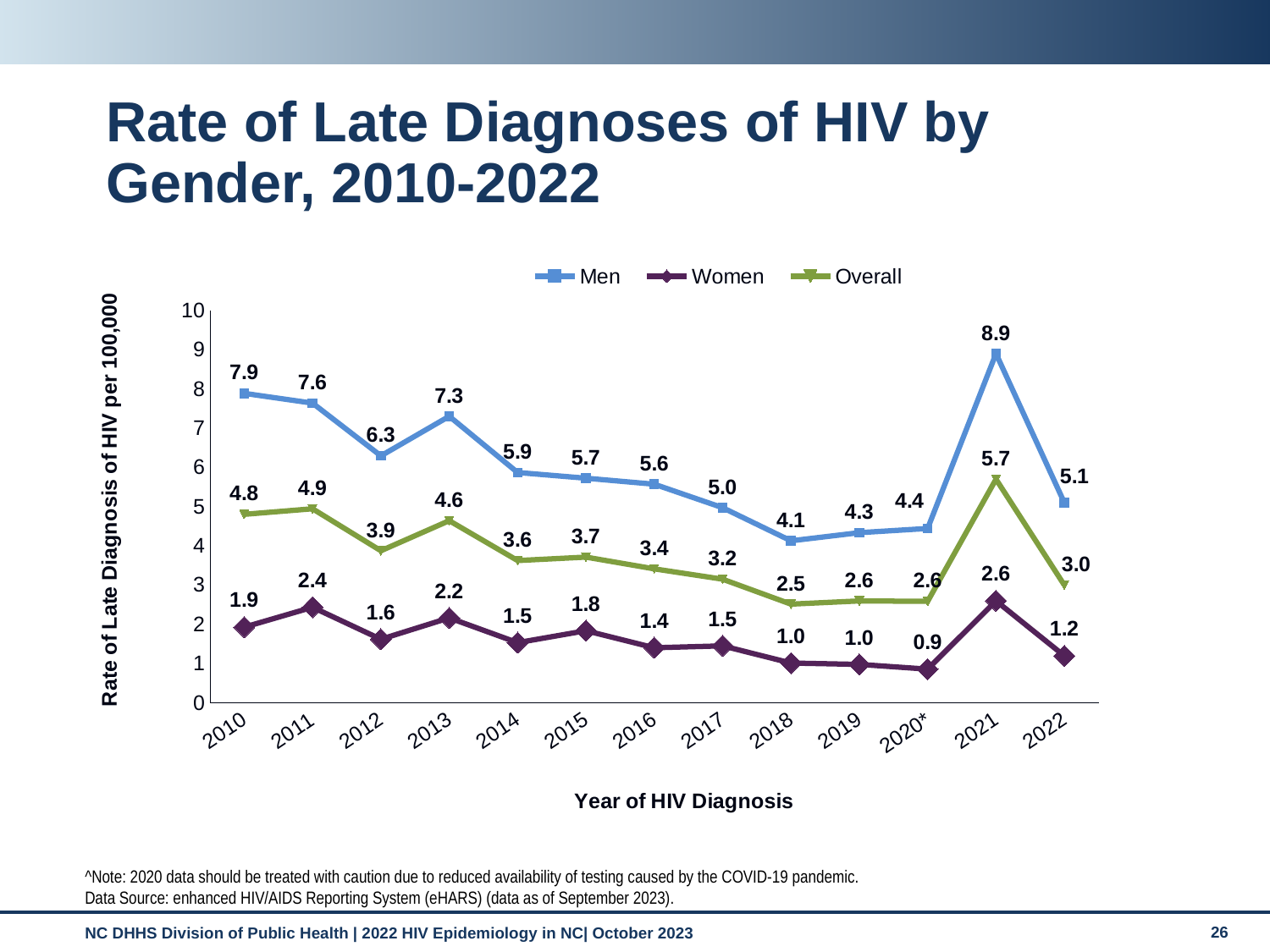
In which year is the rate for Women lowest? 2020* In which year is the rate for Men highest? 2021 What is the rate of late diagnosis of HIV for Men in 2021? 8.9 What is the difference between the Men and Women rates in 2022? 3.9 What kind of chart is shown on the slide? Line chart What is the rate of late diagnosis of HIV for Women in 2020*? 0.9 Does the rate for Men rise or fall from 2010 to 2018? Fall What is the Overall rate of late diagnosis of HIV in 2013? 4.6 How many series does the legend list? 3 How many years are shown on the x axis? 13 Which is larger, the Overall rate in 2010 or the Overall rate in 2022? 2010 What is the label of the y axis? Rate of Late Diagnosis of HIV per 100,000